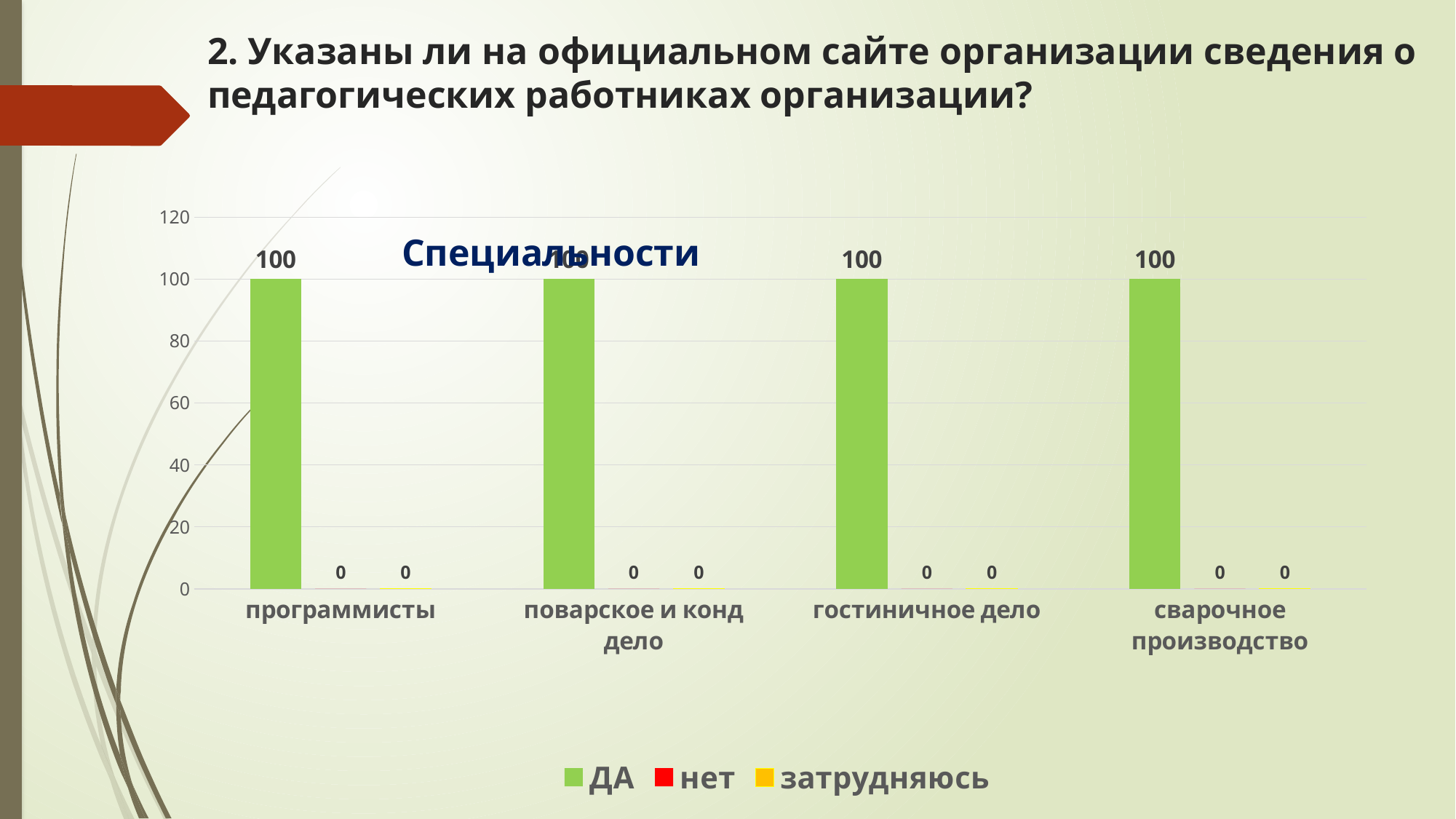
How many categories are shown on the x axis of the chart? 4 What kind of chart is shown on the slide? bar chart Is the ДА value for программисты greater or less than 80? greater What is the title of the chart? Специальности What is the value of the затрудняюсь series for сварочное производство? 0 What is the value of the ДА series for программисты? 100 What is the difference between the ДА value and the нет value for гостиничное дело? 100 What is the value of the ДА series for поварское и конд дело? 100 How many series does the legend list? 3 Which is larger for сварочное производство: the ДА value or the затрудняюсь value? ДА What is the value of the нет series for гостиничное дело? 0 Which colour represents the ДА series in the legend? green